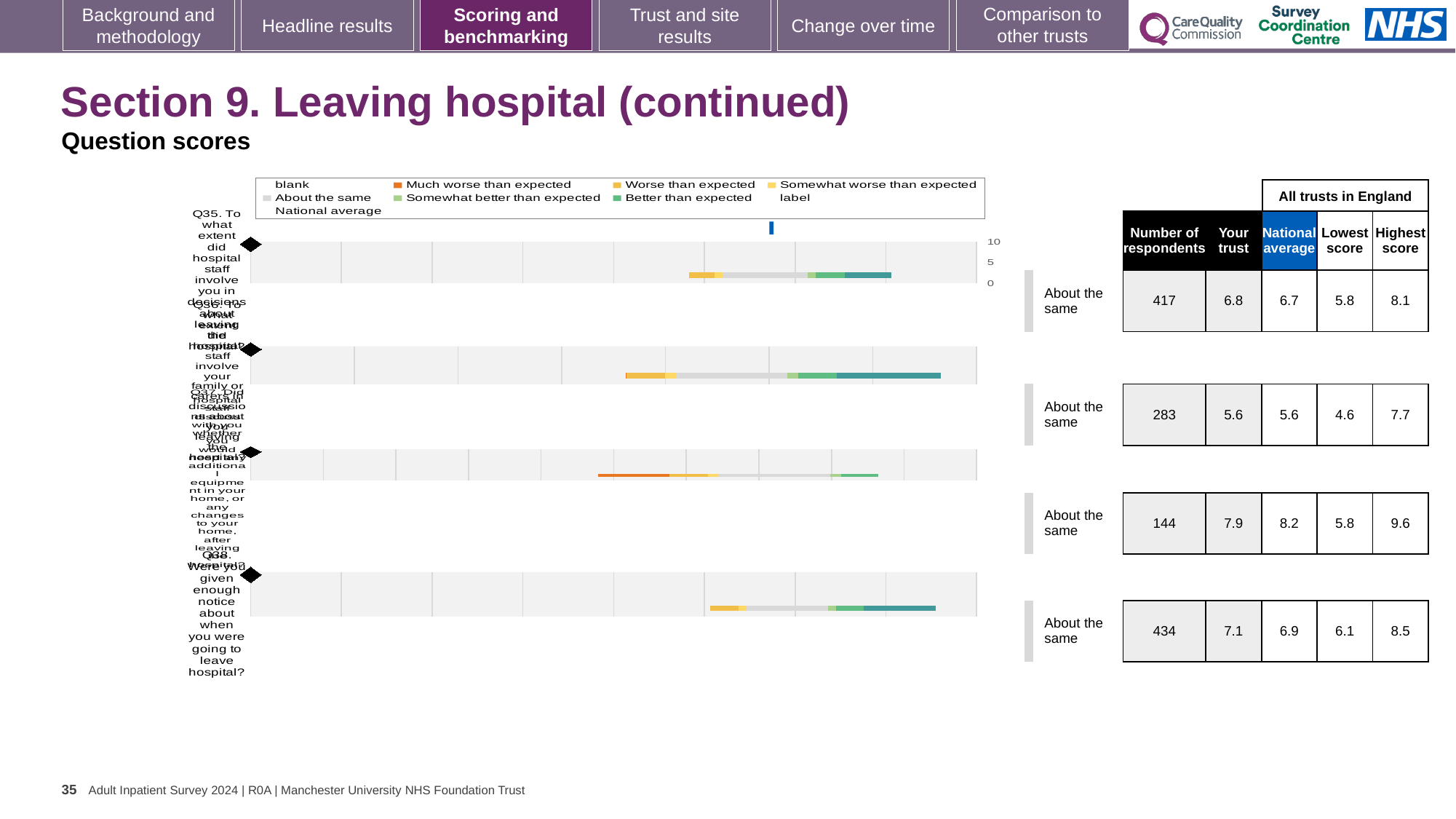
For Q38 (given enough notice about when you were going to leave hospital), what is the 'Your trust' score? 7.1 For Q38, which is larger: the 'Your trust' score or the 'National average'? Your trust What benchmark category is shown next to the Q35 chart? About the same For Q36 (second chart from the top), what is the 'National average' score? 5.6 In the chart legend, what colour is used for 'Much worse than expected'? orange What kind of chart is used to show the question scores on this slide? bar chart Which question row has the lowest number of respondents? Q37 (144) For Q35, what is the difference between the highest score (8.1) and the lowest score (5.8)? 2.3 Which question row has the highest 'Highest score' value across all trusts in England? Q37 (9.6) How many entries does the chart legend list? 9 How many questions (Q35 to Q38) have a benchmark bar chart on this slide? 4 For Q35 (involving you in decisions about leaving hospital), what is the number of respondents? 417